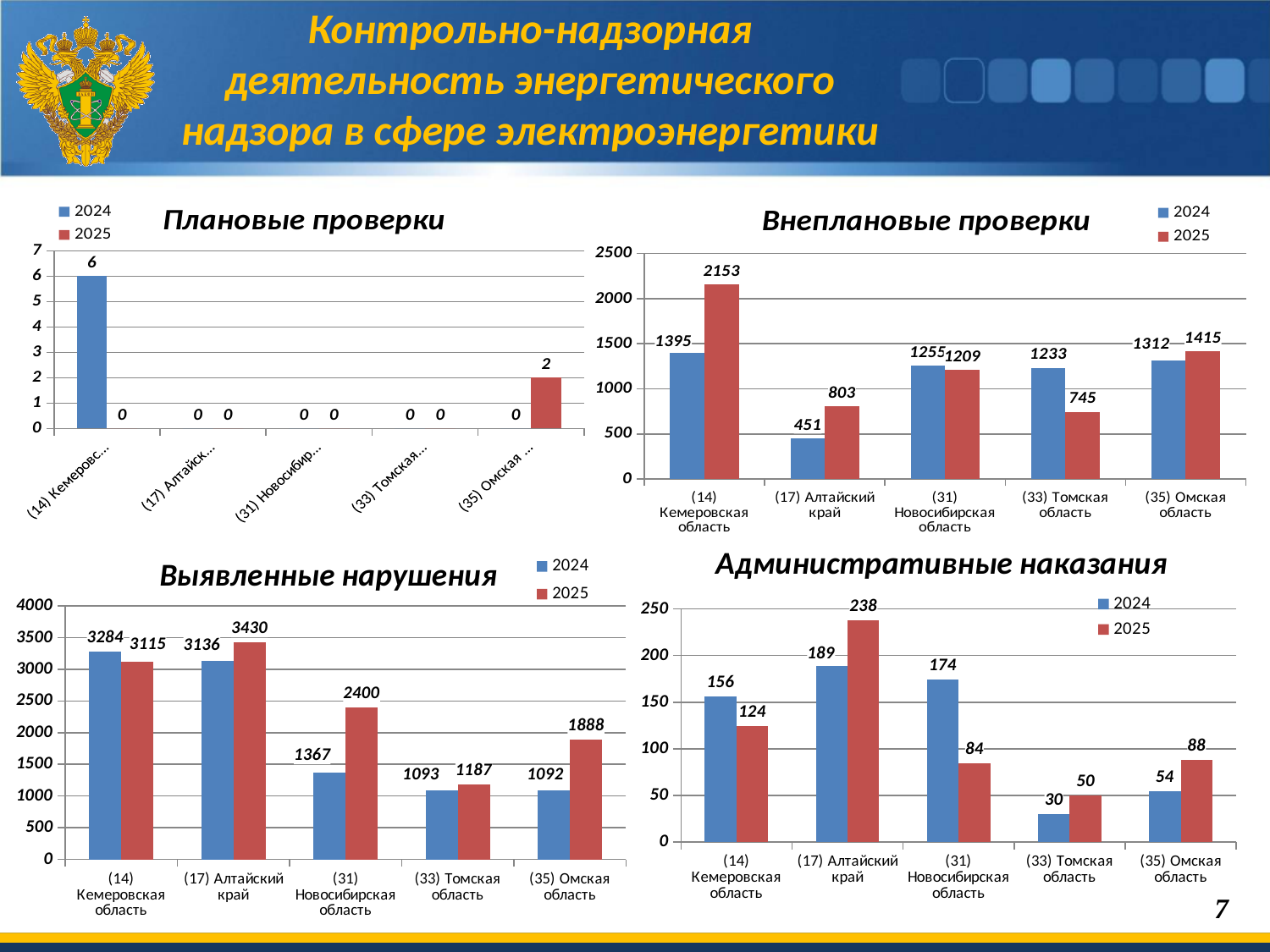
What type of chart is 'Административные наказания'? Bar chart How many series does the legend of the chart 'Внеплановые проверки' list? 2 In the chart 'Административные наказания', what is the difference between the 2025 and 2024 values for (17) Алтайский край? 49 In the chart 'Плановые проверки', what is the 2024 value for (14) Кемеровская область? 6 In the chart 'Выявленные нарушения', which category has the highest 2025 value? (17) Алтайский край In the chart 'Выявленные нарушения', what is the 2025 value for (31) Новосибирская область? 2400 In the chart 'Административные наказания', which category has the lowest 2024 value? (33) Томская область In the chart 'Внеплановые проверки', what is the difference between the 2024 and 2025 values for (33) Томская область? 488 In the chart 'Внеплановые проверки', what is the 2025 value for (14) Кемеровская область? 2153 In the chart 'Внеплановые проверки', which category has the lowest 2024 value? (17) Алтайский край In the chart 'Выявленные нарушения', which is larger for (14) Кемеровская область: the 2024 value or the 2025 value? 2024 In the chart 'Административные наказания', what is the 2024 value for (31) Новосибирская область? 174